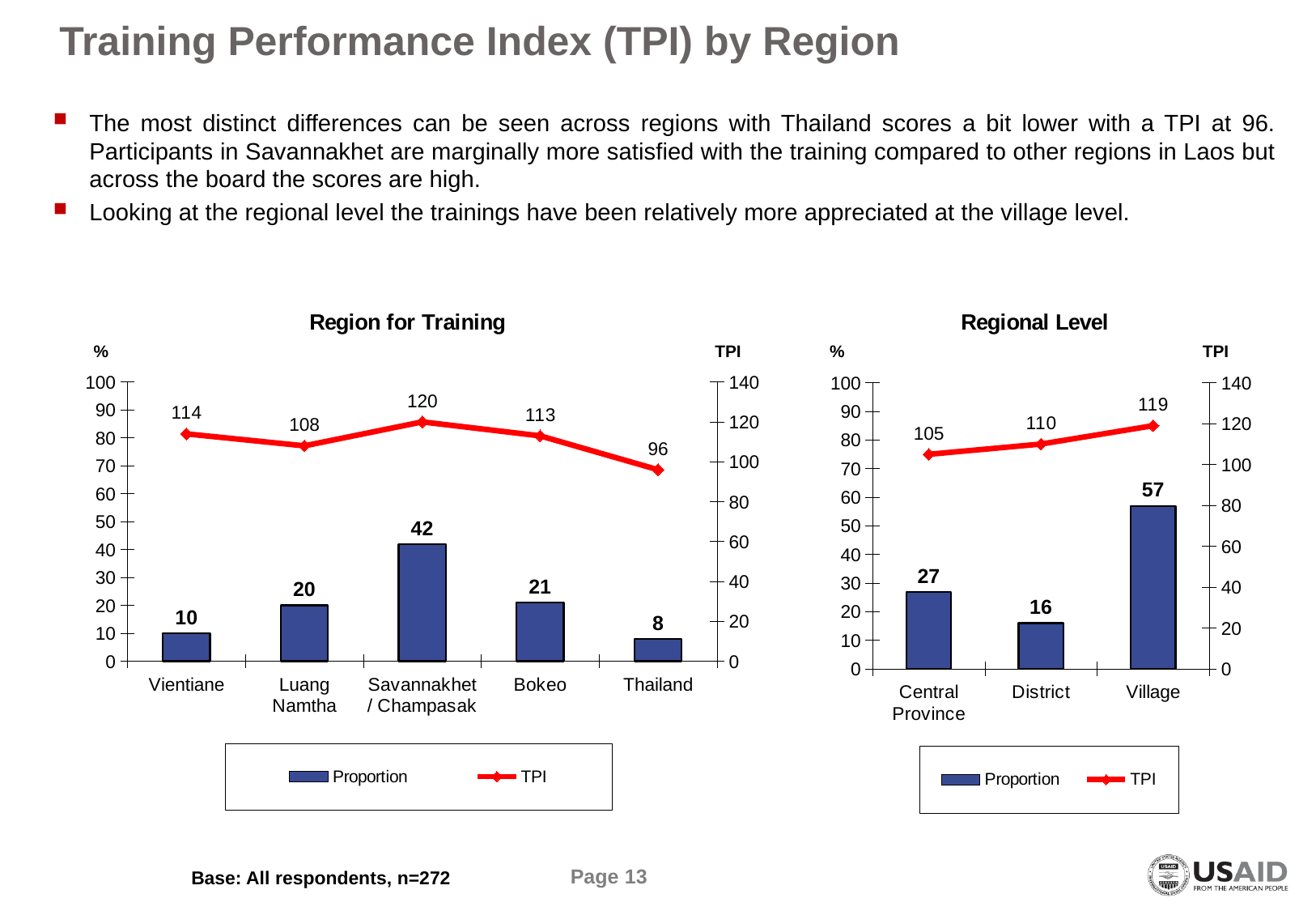
In the 'Region for Training' chart, what kind of chart is used to show the Proportion series? bar chart In the 'Regional Level' chart, does the TPI rise or fall from Central Province to Village? rise In the 'Region for Training' chart, what is the Proportion value for Bokeo? 21 In the 'Region for Training' chart, which region has the lowest TPI? Thailand In the 'Regional Level' chart, which level has the lowest Proportion? District In the 'Region for Training' chart, what is the TPI value for Savannakhet / Champasak? 120 In the 'Region for Training' chart, what is the difference between the TPI for Vientiane and the TPI for Thailand? 18 In the 'Region for Training' chart, how many regions are shown on the x axis? 5 In the 'Region for Training' chart, which region has the highest Proportion? Savannakhet / Champasak In the 'Regional Level' chart, what is the TPI value for District? 110 In the 'Regional Level' chart, what is the Proportion value for Village? 57 In the 'Regional Level' chart, how many series does the legend list? 2